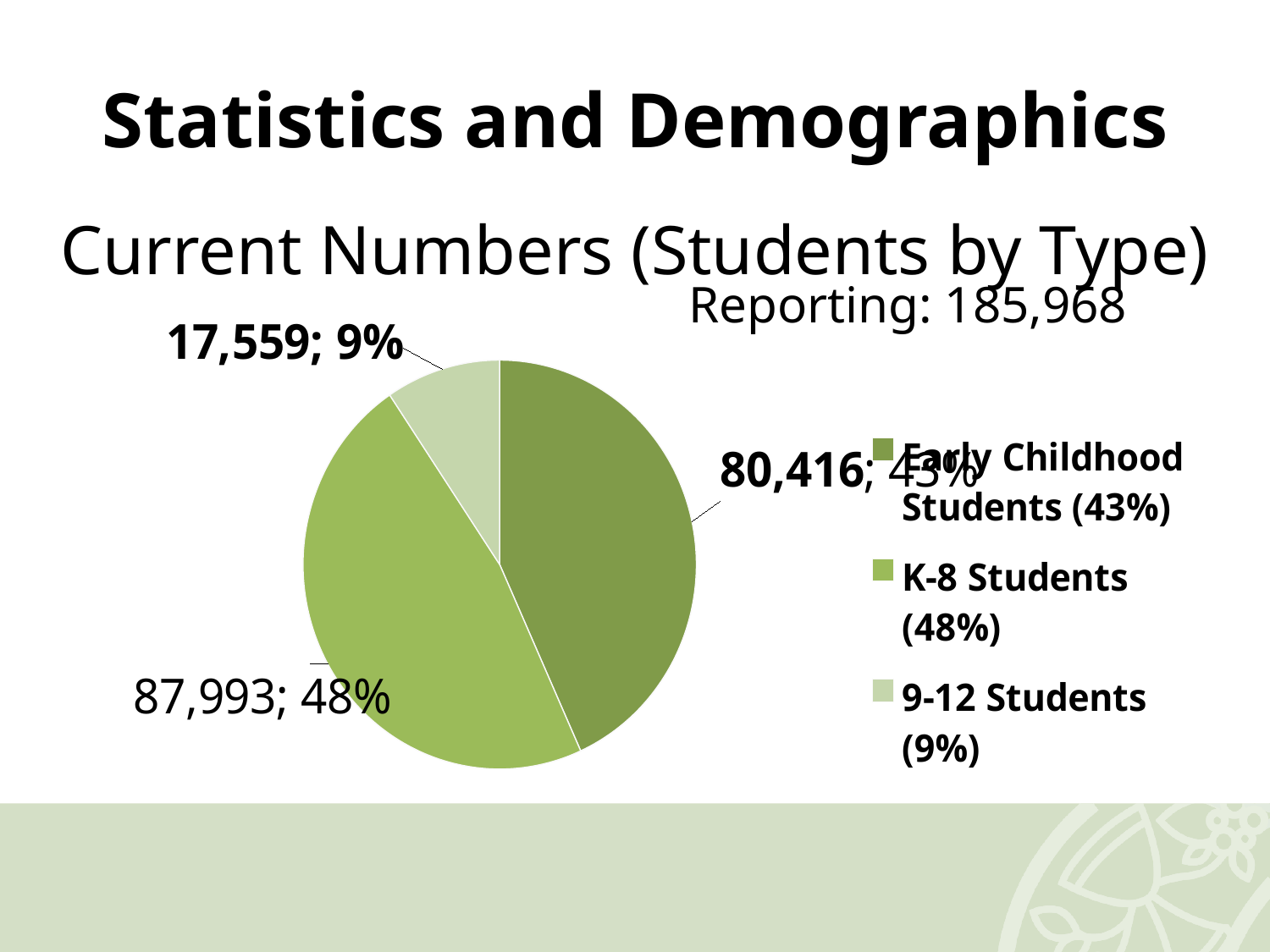
What is the title of the pie chart? Current Numbers (Students by Type) Which student type has the largest slice of the pie? K-8 Students Which student type has the smallest slice of the pie? 9-12 Students What type of chart is shown on the slide? Pie chart What is the difference between the number of K-8 Students and the number of Early Childhood Students? 7,577 Which is larger, the number of Early Childhood Students or the number of 9-12 Students? Early Childhood Students What is the number of K-8 Students shown on the pie chart? 87,993 How many slices does the pie chart have? 3 What is the number of 9-12 Students shown on the pie chart? 17,559 What share of the pie do 9-12 Students represent? 9% What is the number of Early Childhood Students shown on the pie chart? 80,416 How many entries does the legend list? 3